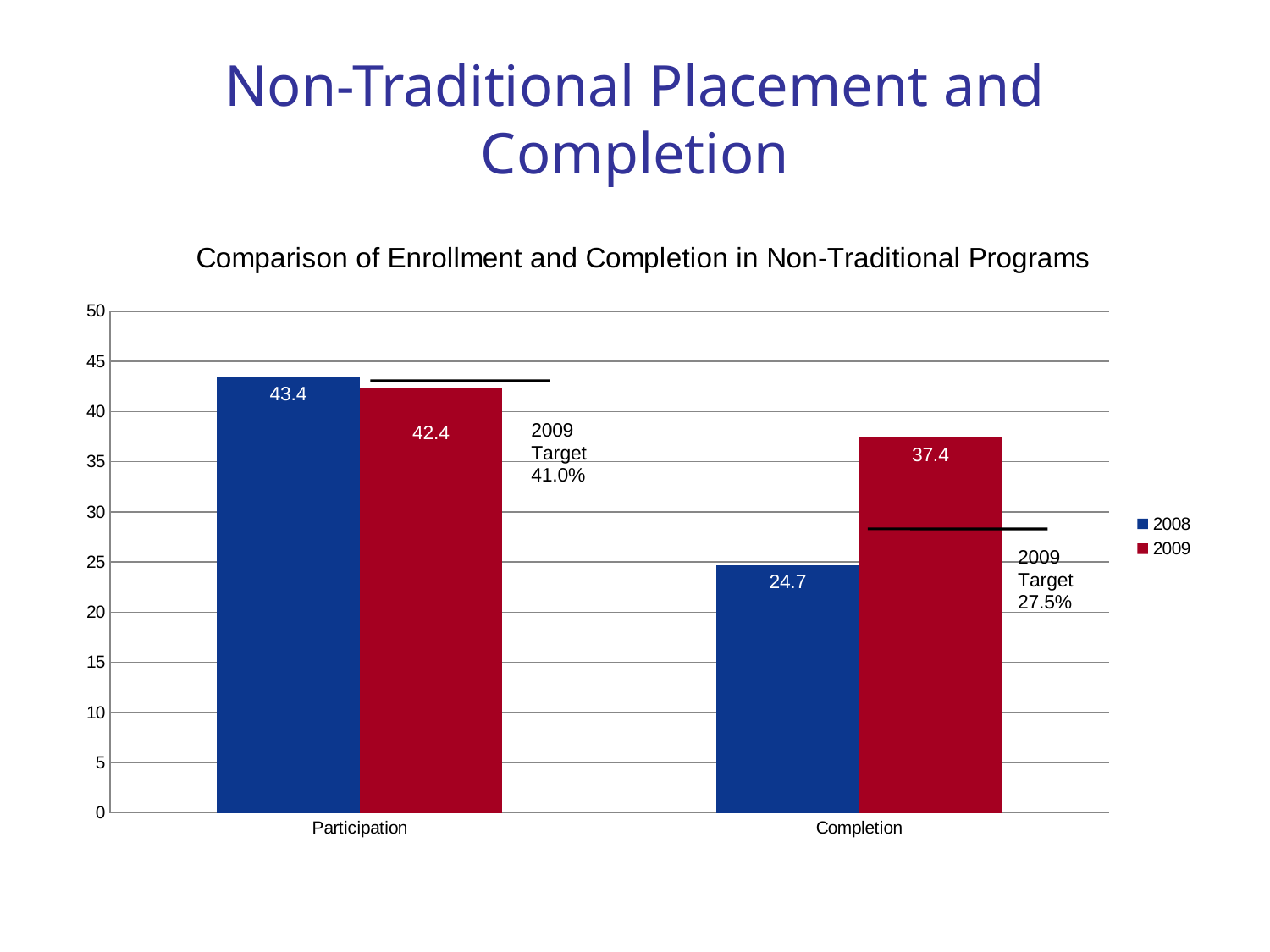
Which category has the highest 2008 value? Participation What is the 2009 Target shown for Completion? 27.5% What is the 2009 value for Participation? 42.4 What is the difference between the 2009 and 2008 values for Completion? 12.7 Which is larger for Participation, the 2008 value or the 2009 value? 2008 What is the 2009 value for Completion? 37.4 How many categories are shown on the x axis? 2 How many series does the legend list? 2 What is the 2008 value for Completion? 24.7 What kind of chart is shown on the slide? Bar chart Which category has the lowest 2009 value? Completion What is the 2008 value for Participation? 43.4